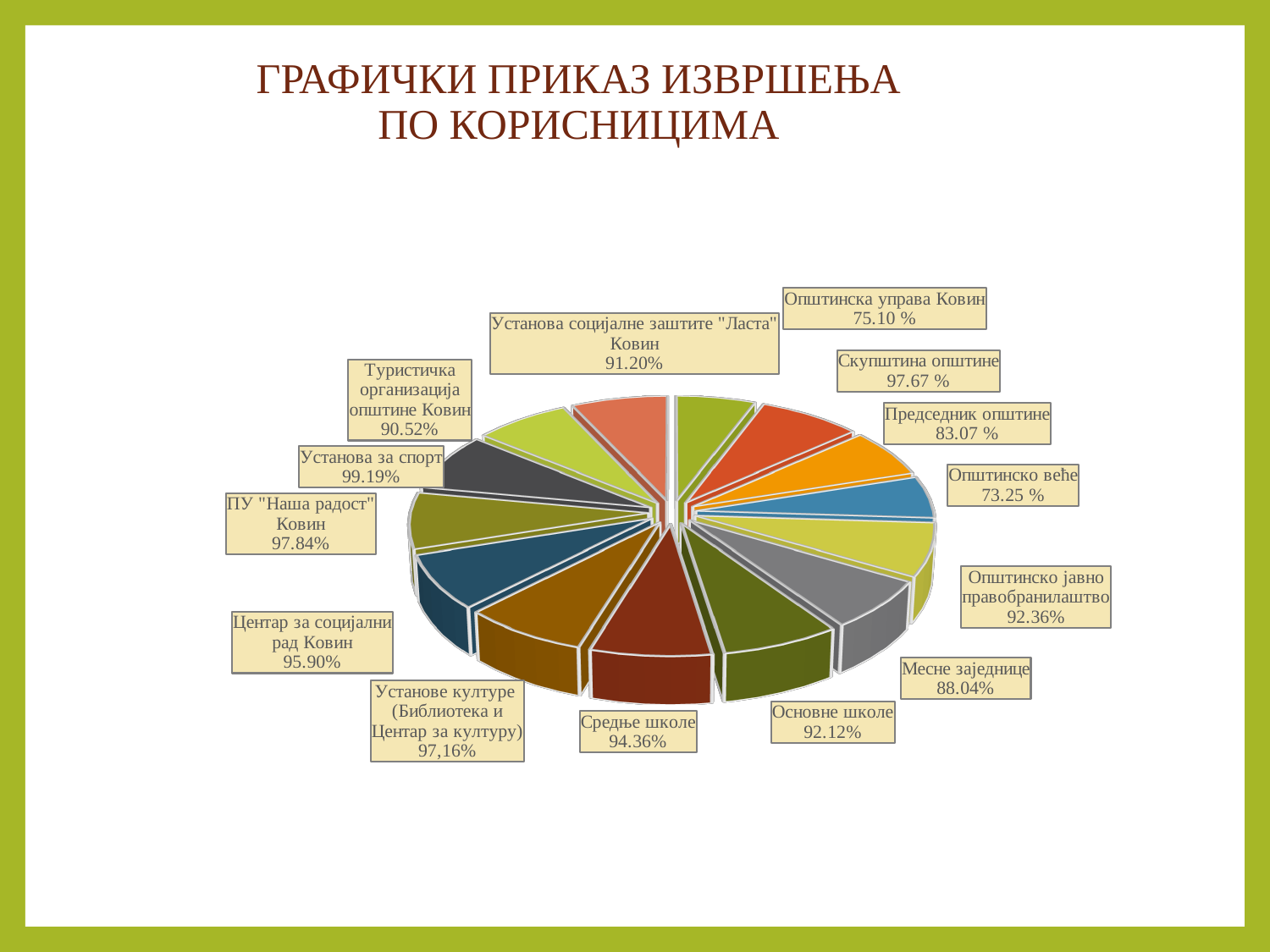
Which category has the highest value shown in its label? Установа за спорт What is the value shown for Туристичка организација општине Ковин? 90.52% Which category has the lowest value shown in its label? Општинско веће What is the title of the slide containing the chart? ГРАФИЧКИ ПРИКАЗ ИЗВРШЕЊА ПО КОРИСНИЦИМА What is the value shown for Установа за спорт? 99.19% What is the difference between the values for Скупштина општине and Општинска управа Ковин? 22.57 % Which has a higher value, Основне школе or Средње школе? Средње школе What is the value shown for Општинска управа Ковин? 75.10 % How many categories (slices) does the pie chart have? 14 What is the value shown for Месне заједнице? 88.04% What kind of chart is shown on the slide? pie chart What is the value shown for Средње школе? 94.36%